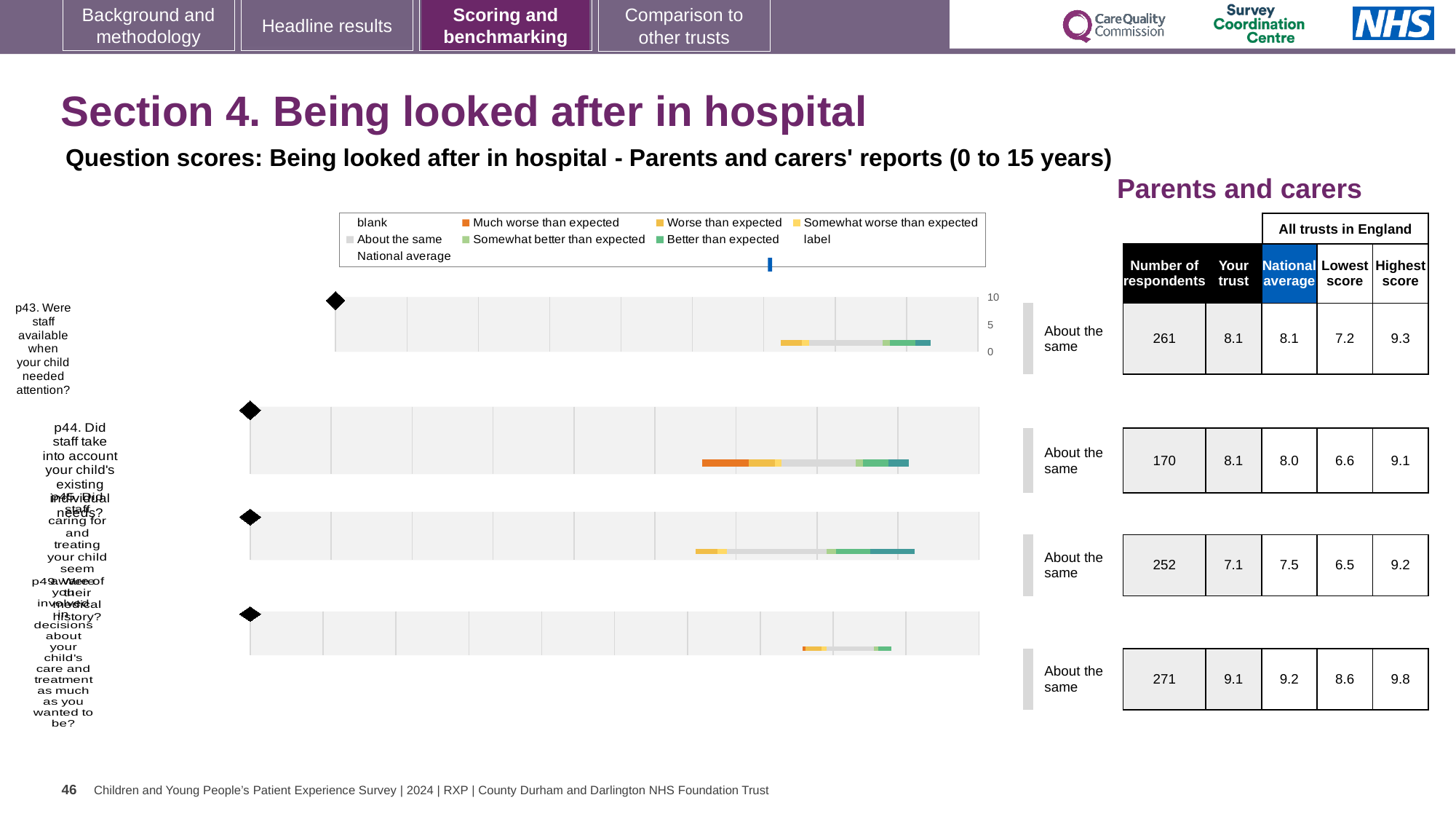
For question p44, which is larger: the 'Your trust' score or the national average? Your trust (8.1 vs 8.0) What is the 'Your trust' score for question p43? 8.1 For the third question row (p45), what is the difference between the national average and the 'Your trust' score? 0.4 What is the highest score among all trusts in England for question p43? 9.3 Which question row has the lowest 'Your trust' score? p45 (the third row), 7.1 How many question rows (charts) are shown on the slide? 4 What benchmark category is shown next to each of the four question rows? About the same For question p43 (Were staff available when your child needed attention?), how many respondents are shown in the table? 261 What is the lowest score among all trusts in England for question p44 (Did staff take into account your child's existing individual needs?)? 6.6 What is the national average score for the third question row (p45)? 7.5 Which question row has the highest 'Your trust' score? p49 (the bottom row), 9.1 What kind of chart is used to show the question scores? Bar chart